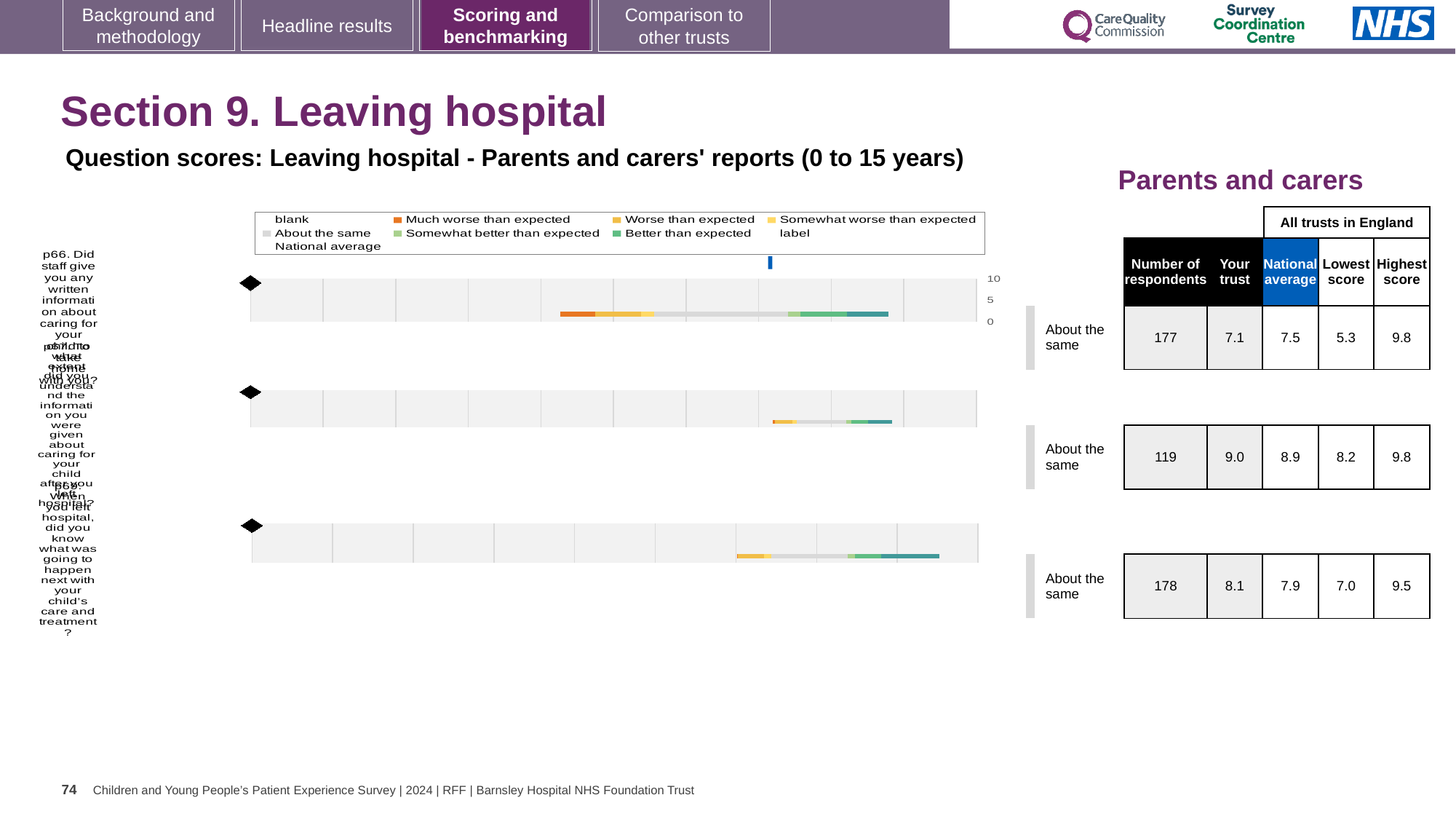
In the table beside the charts, what is the national average for the third question (p68)? 7.9 What benchmark category is shown next to each of the three charts? About the same How many separate question-score charts are shown on the slide? 3 In the table beside the charts, what is the difference between the highest score and the lowest score for the third question (p68)? 2.5 What is the highest tick value shown on the axis of the top chart? 10 What colour does the legend use for 'Much worse than expected'? orange What kind of chart is used to show the question scores on this slide? bar chart In the table beside the charts, what is the 'Your trust' score for the first question (p66)? 7.1 In the table beside the charts, which question has the highest 'Your trust' score? the second question (9.0) In the table beside the charts, is the 'Your trust' score for the first question (p66) higher or lower than the national average? lower In the table beside the charts, how many respondents answered the second question? 119